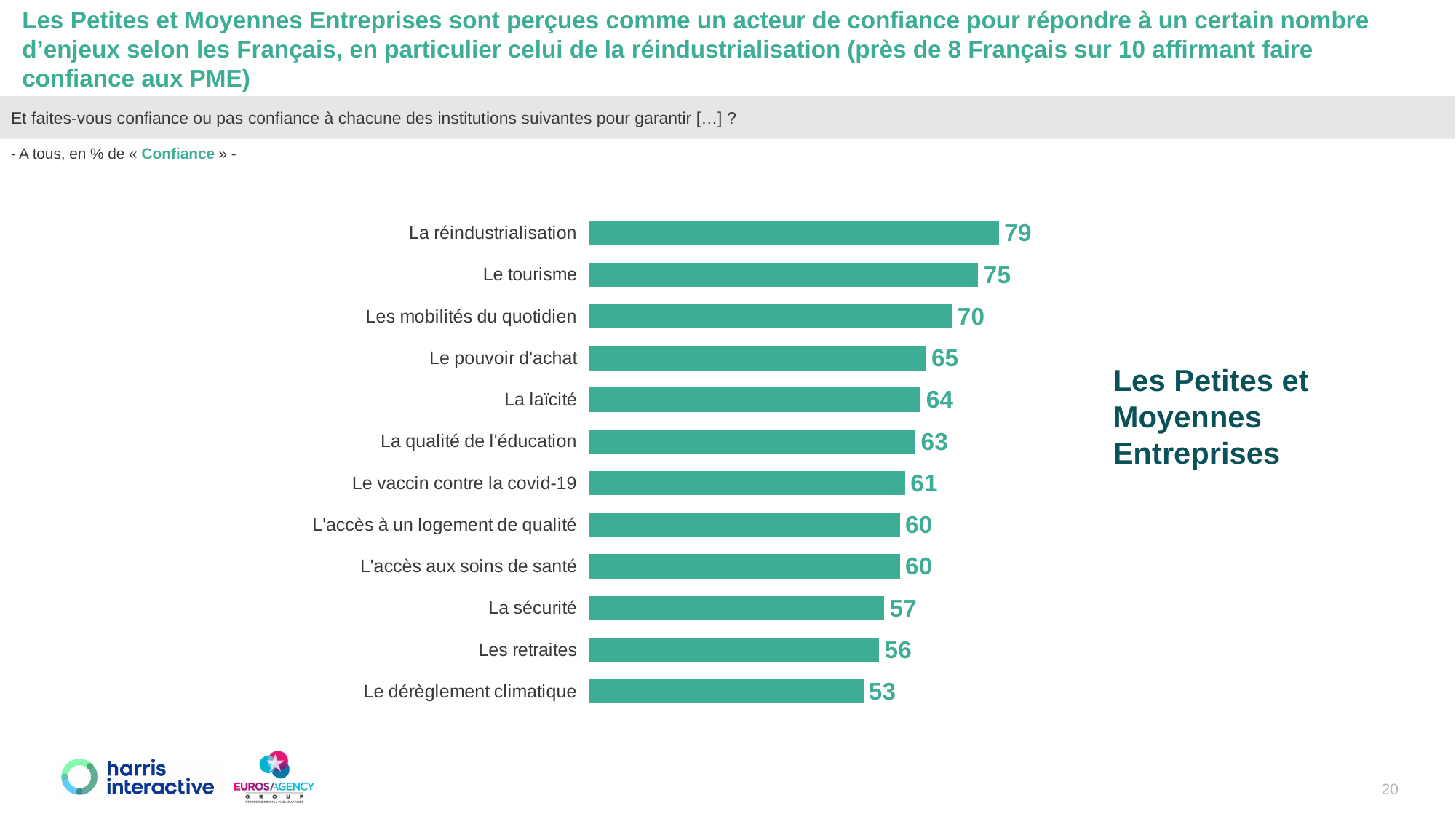
What is the value for Les retraites? 56 How many categories are shown in the chart? 12 What is the difference between the values for Le tourisme and Le pouvoir d'achat? 10 What is the difference between the values for La réindustrialisation and Le dérèglement climatique? 26 Which is larger, the value for Les mobilités du quotidien or the value for La sécurité? Les mobilités du quotidien What is the value for La réindustrialisation? 79 What kind of chart is shown on the slide? Bar chart Which category has the highest value? La réindustrialisation Do the values rise or fall from the top category to the bottom category? Fall Which category has the lowest value? Le dérèglement climatique What label is shown to the right of the chart? Les Petites et Moyennes Entreprises What is the value for Le vaccin contre la covid-19? 61